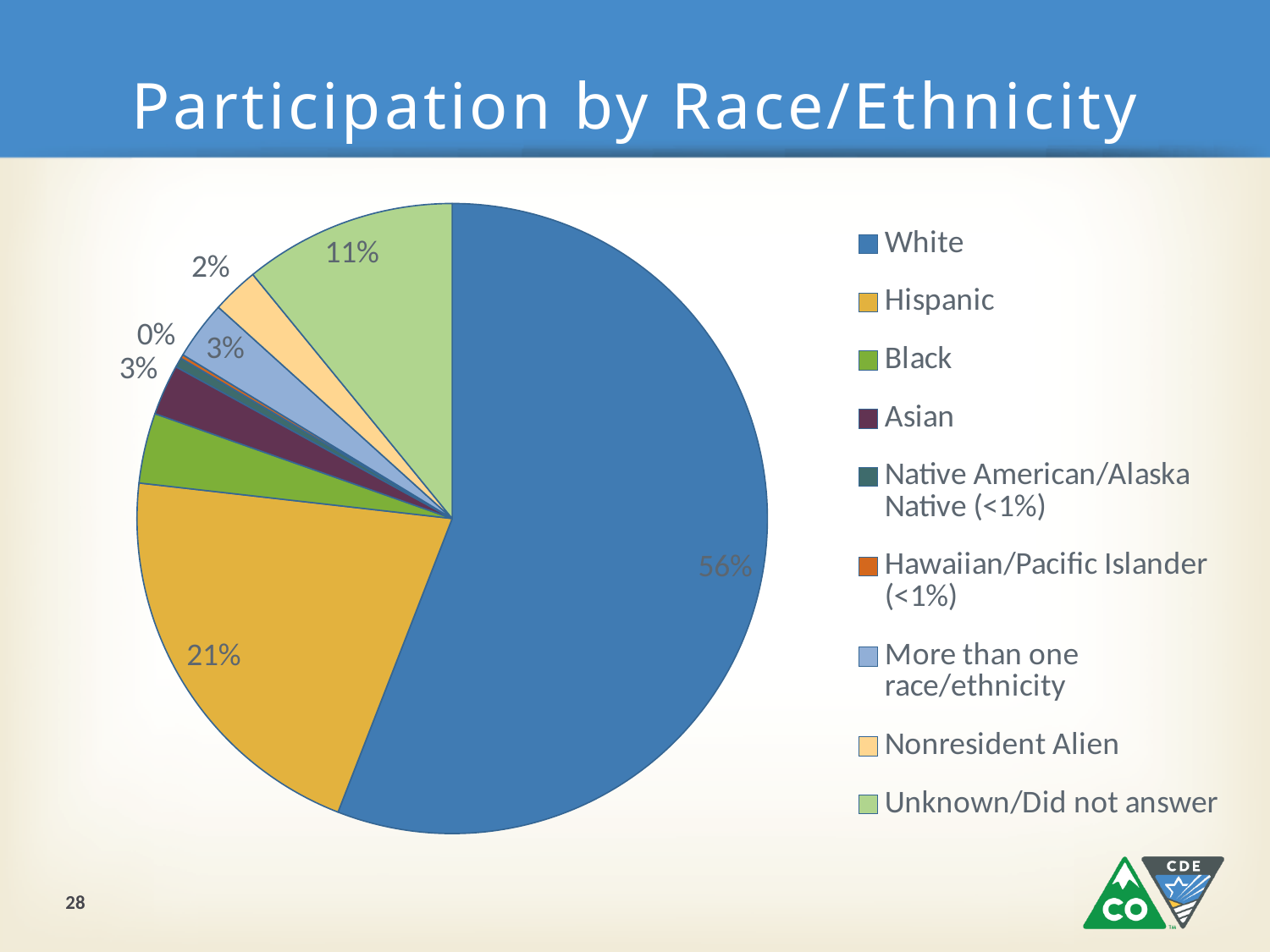
Which two categories are marked as less than 1% in the legend? Native American/Alaska Native and Hawaiian/Pacific Islander Which is larger, the White share or the Hispanic share? White What type of chart is shown on the slide? Pie chart Which race/ethnicity category has the largest share of the pie? White Is the White share of the pie greater or less than 50%? greater How many race/ethnicity categories does the legend list? 9 What percentage of participation is White? 56% What percentage of participation is Unknown/Did not answer? 11% What is the difference in percentage points between the White share and the Hispanic share? 35% What percentage of participation is Hispanic? 21% What percentage of participation is Nonresident Alien? 2% What is the title of the chart? Participation by Race/Ethnicity